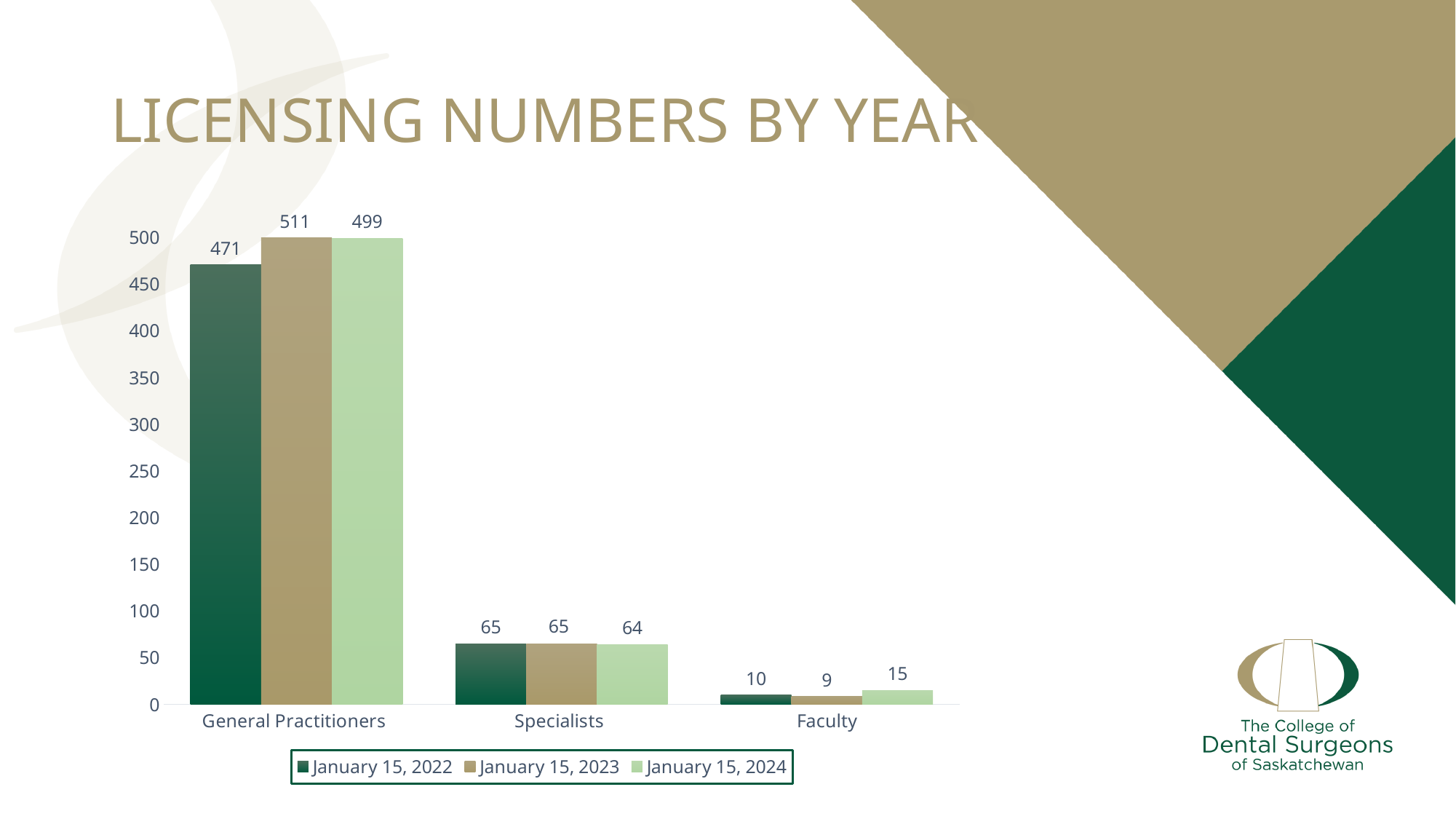
Which category has the highest value on January 15, 2024? General Practitioners What is the value for General Practitioners on January 15, 2023? 511 How many series does the legend list? 3 What is the difference between the General Practitioners values for January 15, 2023 and January 15, 2022? 40 Is the value for General Practitioners on January 15, 2022 greater or less than 450? greater What is the value for Specialists on January 15, 2022? 65 What is the value for Faculty on January 15, 2024? 15 Which is larger for Faculty: the January 15, 2022 value or the January 15, 2024 value? January 15, 2024 Which category has the lowest value on January 15, 2022? Faculty What is the title of the chart? LICENSING NUMBERS BY YEAR What kind of chart is shown on the slide? bar chart How many categories are shown on the x axis? 3